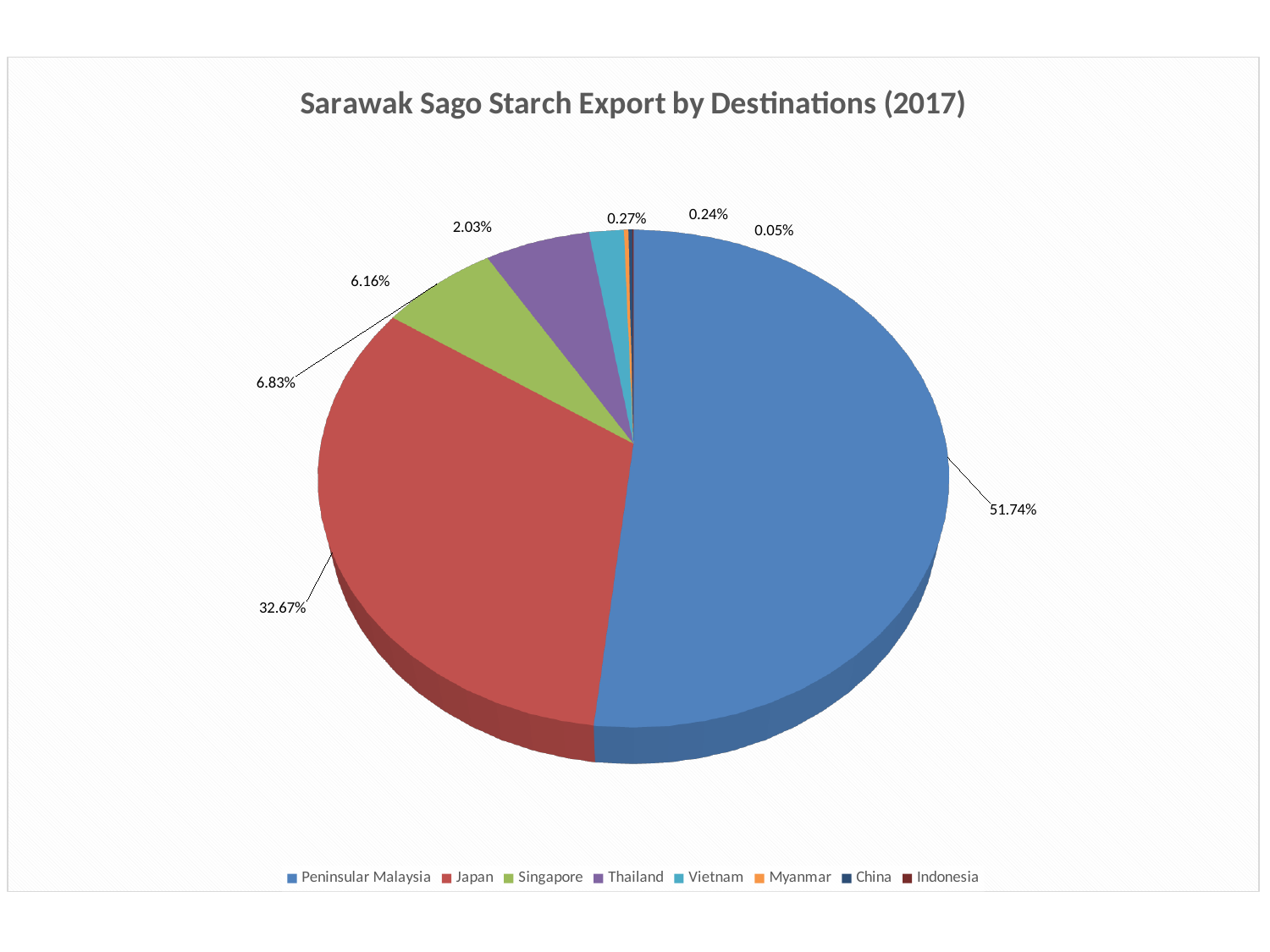
What is the title of the chart? Sarawak Sago Starch Export by Destinations (2017) What kind of chart is shown on the slide? Pie chart What share of exports went to Singapore? 6.83% What share of exports went to Japan? 32.67% How many destinations does the legend list? 8 What share of Sarawak sago starch exports went to Peninsular Malaysia? 51.74% Which destination has the largest share of exports? Peninsular Malaysia Which has the larger share of exports, Japan or Singapore? Japan Which destination has the smallest share of exports? Indonesia What is the difference in percentage points between the shares for Peninsular Malaysia and Japan? 19.07